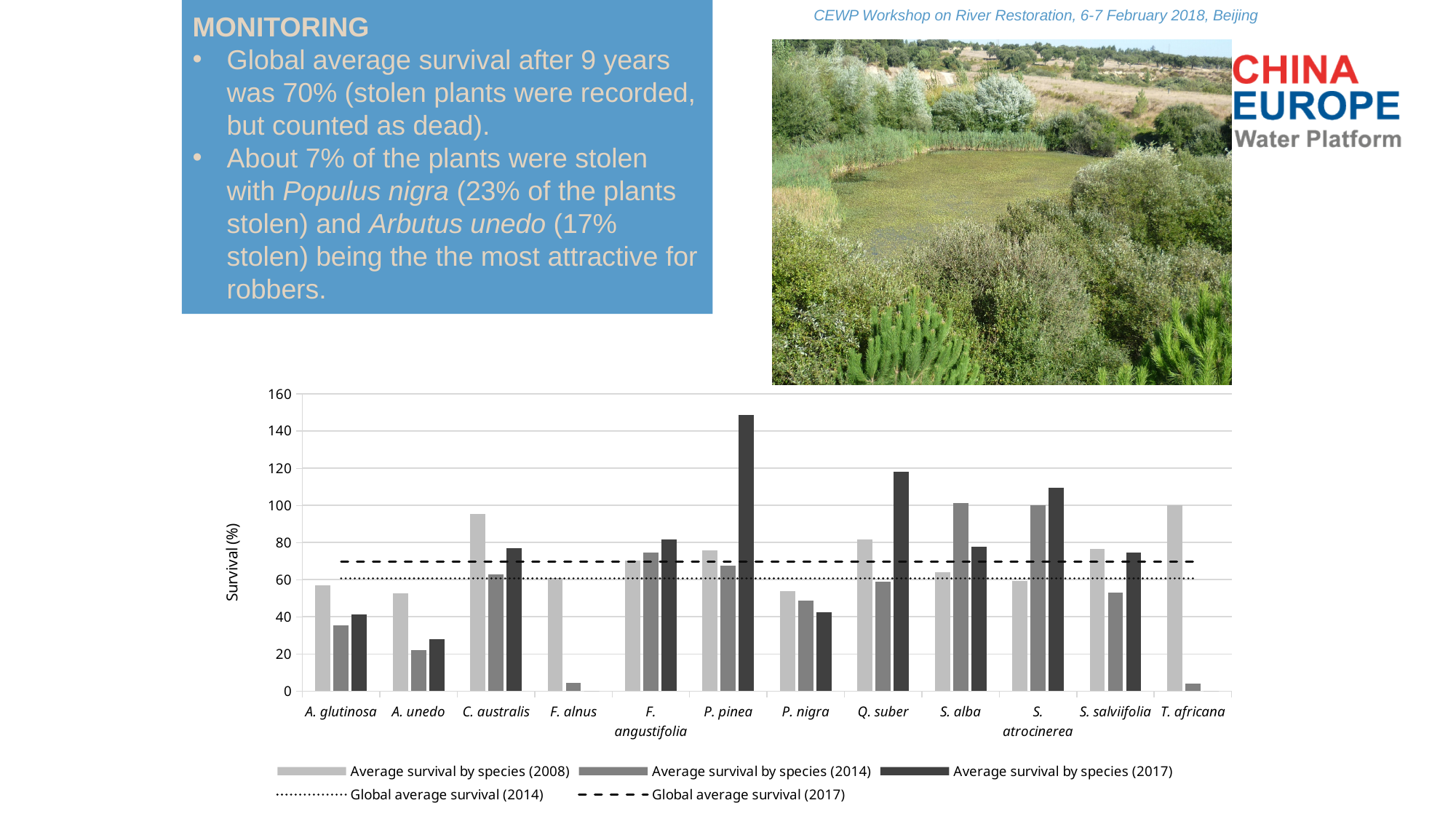
Is the Average survival by species (2017) value for S. atrocinerea greater or less than 100? greater Which is larger: the Average survival by species (2017) value for Q. suber or for S. atrocinerea? Q. suber What is the label on the y axis of the chart? Survival (%) How many species categories are shown on the x axis of the chart? 12 Is the Average survival by species (2014) value for A. unedo greater or less than 40? less What kind of chart is shown on the slide? Combination bar and line chart Is the Average survival by species (2017) value for P. pinea greater or less than 140? greater Which is larger for A. glutinosa: the Average survival by species (2008) value or the Average survival by species (2017) value? Average survival by species (2008) How many entries does the chart legend list? 5 Which species has the highest Average survival by species (2017) bar? P. pinea